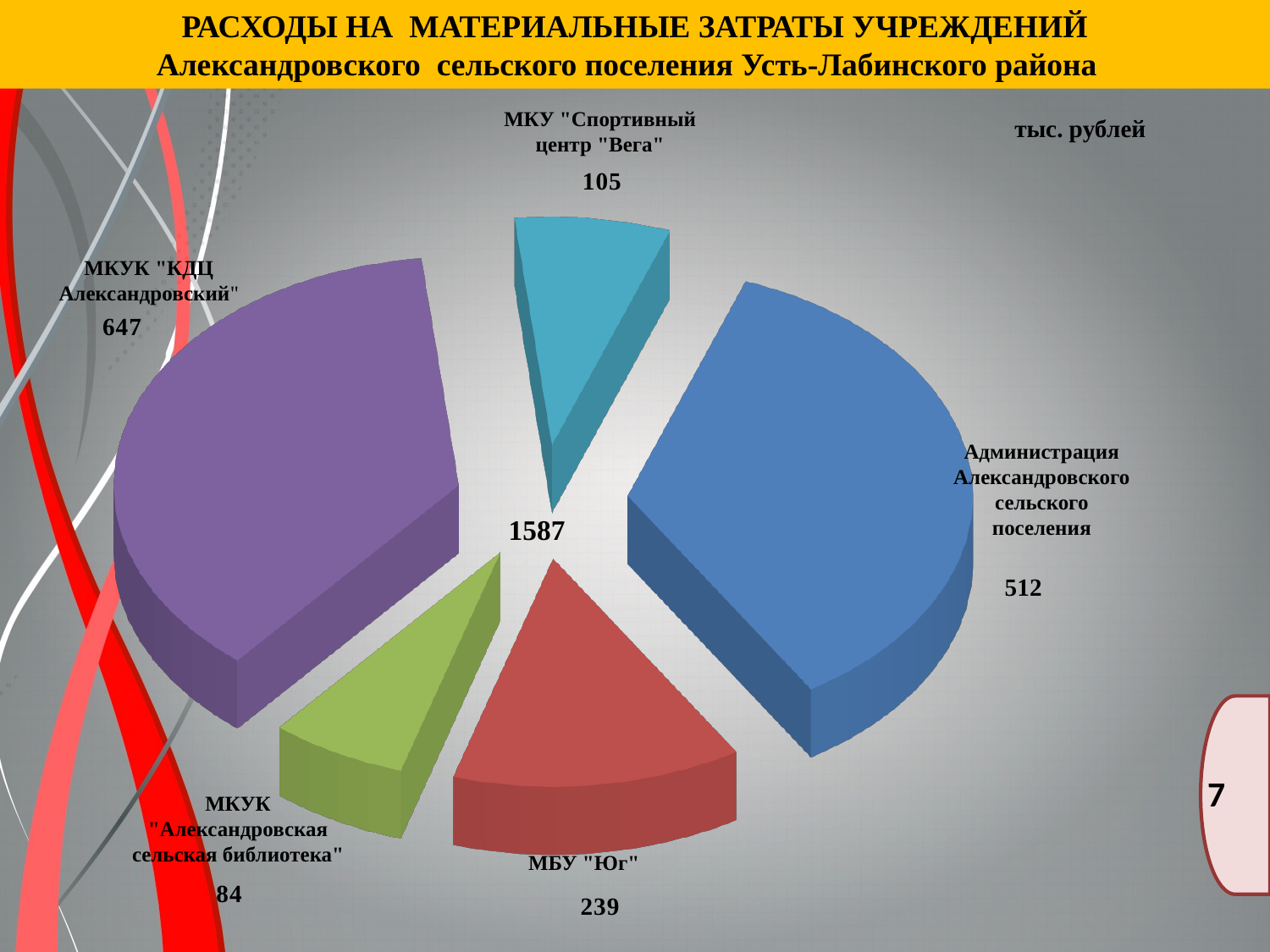
Which is larger, the value for МБУ "Юг" or the value for МКУ "Спортивный центр "Вега""? МБУ "Юг" What kind of chart is shown on the slide? Pie chart Which institution has the smallest share of the pie? МКУК "Александровская сельская библиотека" What is the difference between the values for МКУК "КДЦ Александровский" and Администрация Александровского сельского поселения? 135 How many slices does the pie chart have? 5 In what units are the values on the chart expressed? тыс. рублей Which institution has the largest share of the pie? МКУК "КДЦ Александровский" What is the total of all slices shown in the centre of the pie chart? 1587 What is the value for МКУ "Спортивный центр "Вега""? 105 What is the value for МБУ "Юг"? 239 What is the value for МКУК "КДЦ Александровский"? 647 What is the value for Администрация Александровского сельского поселения? 512